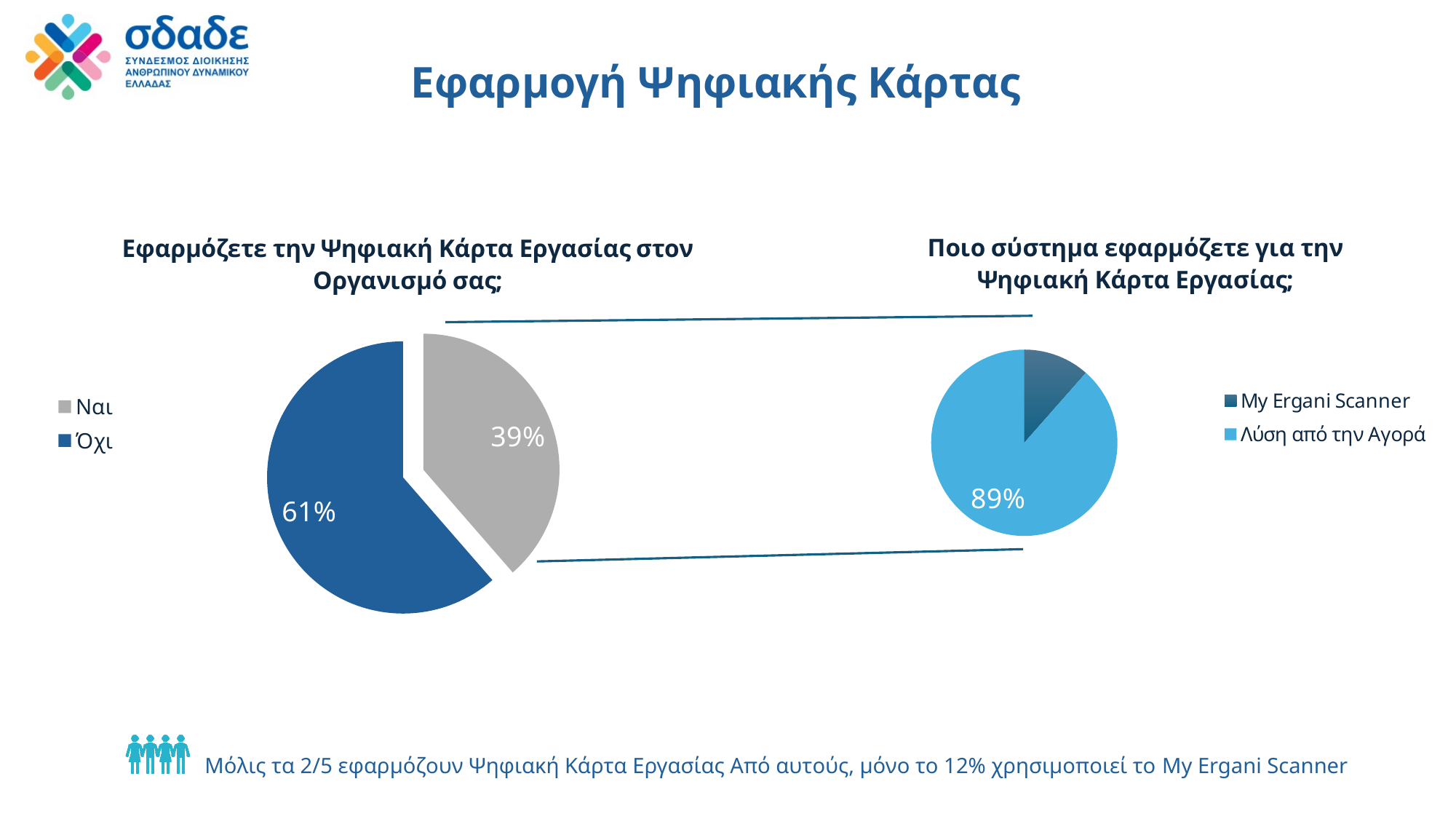
In the left chart (Εφαρμόζετε την Ψηφιακή Κάρτα Εργασίας στον Οργανισμό σας;), which category has the smallest slice? Ναι In the left chart (Εφαρμόζετε την Ψηφιακή Κάρτα Εργασίας στον Οργανισμό σας;), which category has the largest slice? Όχι In the right chart (Ποιο σύστημα εφαρμόζετε για την Ψηφιακή Κάρτα Εργασίας;), which category has the largest slice? Λύση από την Αγορά How many slices does the right chart (Ποιο σύστημα εφαρμόζετε για την Ψηφιακή Κάρτα Εργασίας;) have? 2 In the left chart (Εφαρμόζετε την Ψηφιακή Κάρτα Εργασίας στον Οργανισμό σας;), what share of the pie is labelled Όχι? 61% What type of chart is the right chart (Ποιο σύστημα εφαρμόζετε για την Ψηφιακή Κάρτα Εργασίας;)? Pie chart In the right chart (Ποιο σύστημα εφαρμόζετε για την Ψηφιακή Κάρτα Εργασίας;), which category has the smallest slice? My Ergani Scanner In the right chart (Ποιο σύστημα εφαρμόζετε για την Ψηφιακή Κάρτα Εργασίας;), what share of the pie is Λύση από την Αγορά? 89% In the left chart (Εφαρμόζετε την Ψηφιακή Κάρτα Εργασίας στον Οργανισμό σας;), by how many percentage points does Όχι exceed Ναι? 22 percentage points In the left chart (Εφαρμόζετε την Ψηφιακή Κάρτα Εργασίας στον Οργανισμό σας;), which is larger, Ναι or Όχι? Όχι In the left chart (Εφαρμόζετε την Ψηφιακή Κάρτα Εργασίας στον Οργανισμό σας;), what share of the pie is labelled Ναι? 39% How many entries does the legend of the left chart (Εφαρμόζετε την Ψηφιακή Κάρτα Εργασίας στον Οργανισμό σας;) list? 2